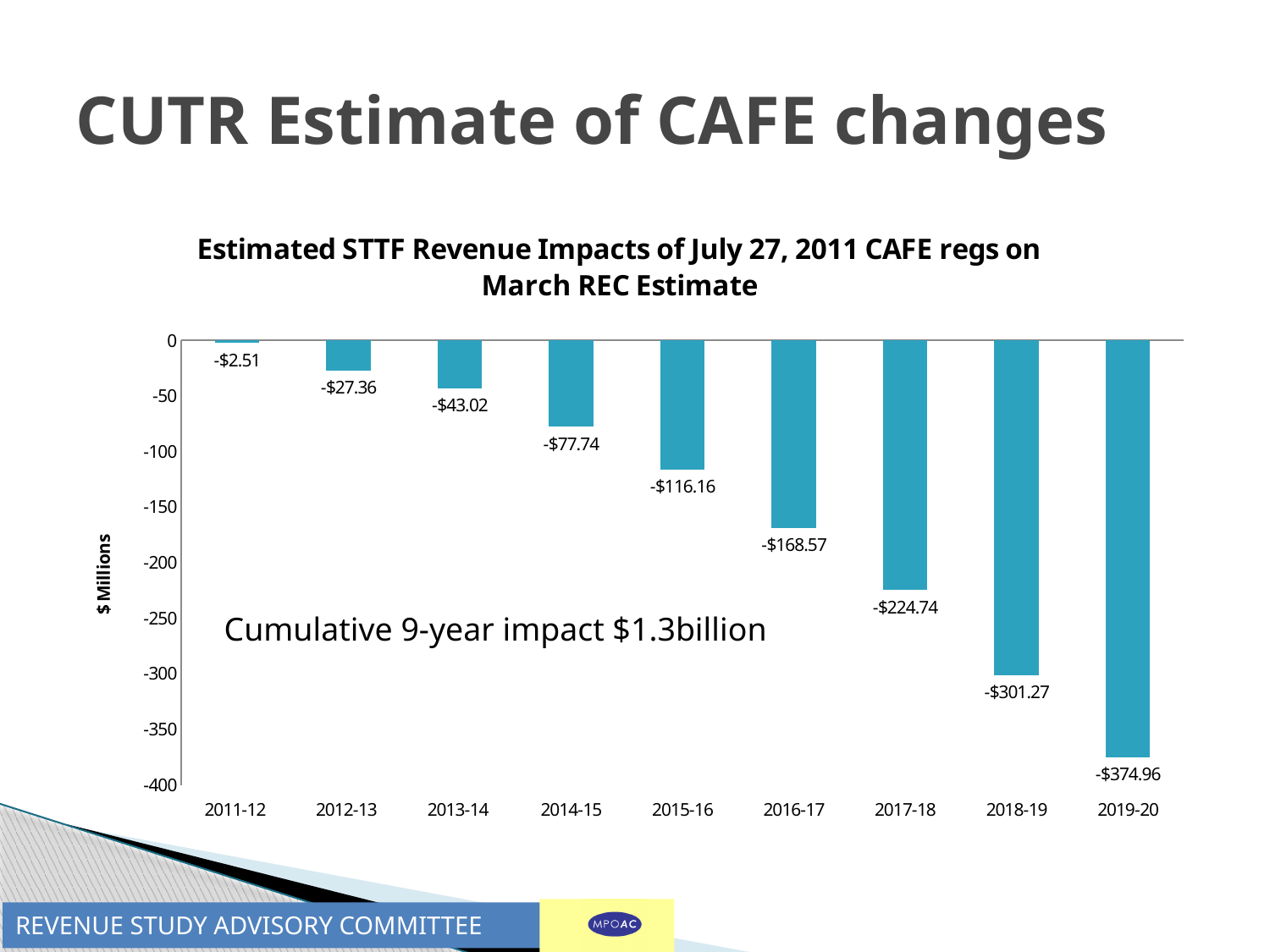
What kind of chart is this? Bar chart What is the value for 2015-16? -$116.16 What is the value for 2018-19? -$301.27 Which year has a more negative value, 2014-15 or 2016-17? 2016-17 What is the difference between the values for 2019-20 and 2018-19? $73.69 Which year has the largest negative revenue impact (the lowest value)? 2019-20 Which year has the smallest revenue impact (the value closest to zero)? 2011-12 Do the values rise or fall from 2011-12 to 2019-20? Fall What is the value for 2019-20? -$374.96 What is the difference between the values for 2017-18 and 2016-17? $56.17 How many years are shown on the x axis? 9 What is the value for 2011-12? -$2.51